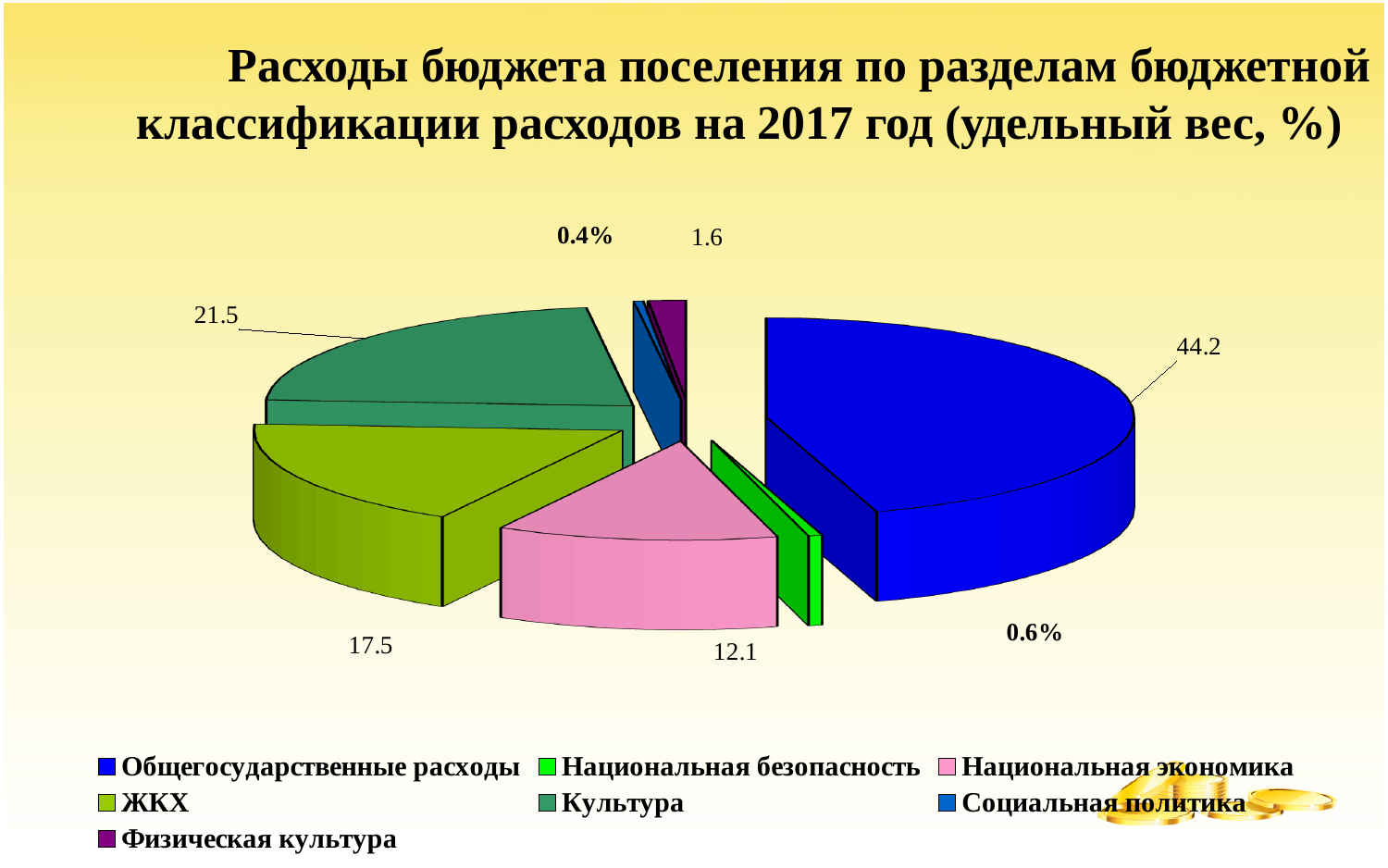
What type of chart is shown on the slide? pie chart How many categories does the legend list? 7 Which category has the largest share of the pie? Общегосударственные расходы What is the share for Национальная безопасность? 0.6% What is the share for Культура? 21.5 Which colour represents Культура in the legend? teal green Which is larger, the share for ЖКХ or the share for Национальная экономика? ЖКХ What is the share for Национальная экономика? 12.1 What is the difference between the shares of Общегосударственные расходы and Культура? 22.7 What is the share for Общегосударственные расходы? 44.2 What is the share for ЖКХ? 17.5 What is the difference between the shares of Культура and ЖКХ? 4.0